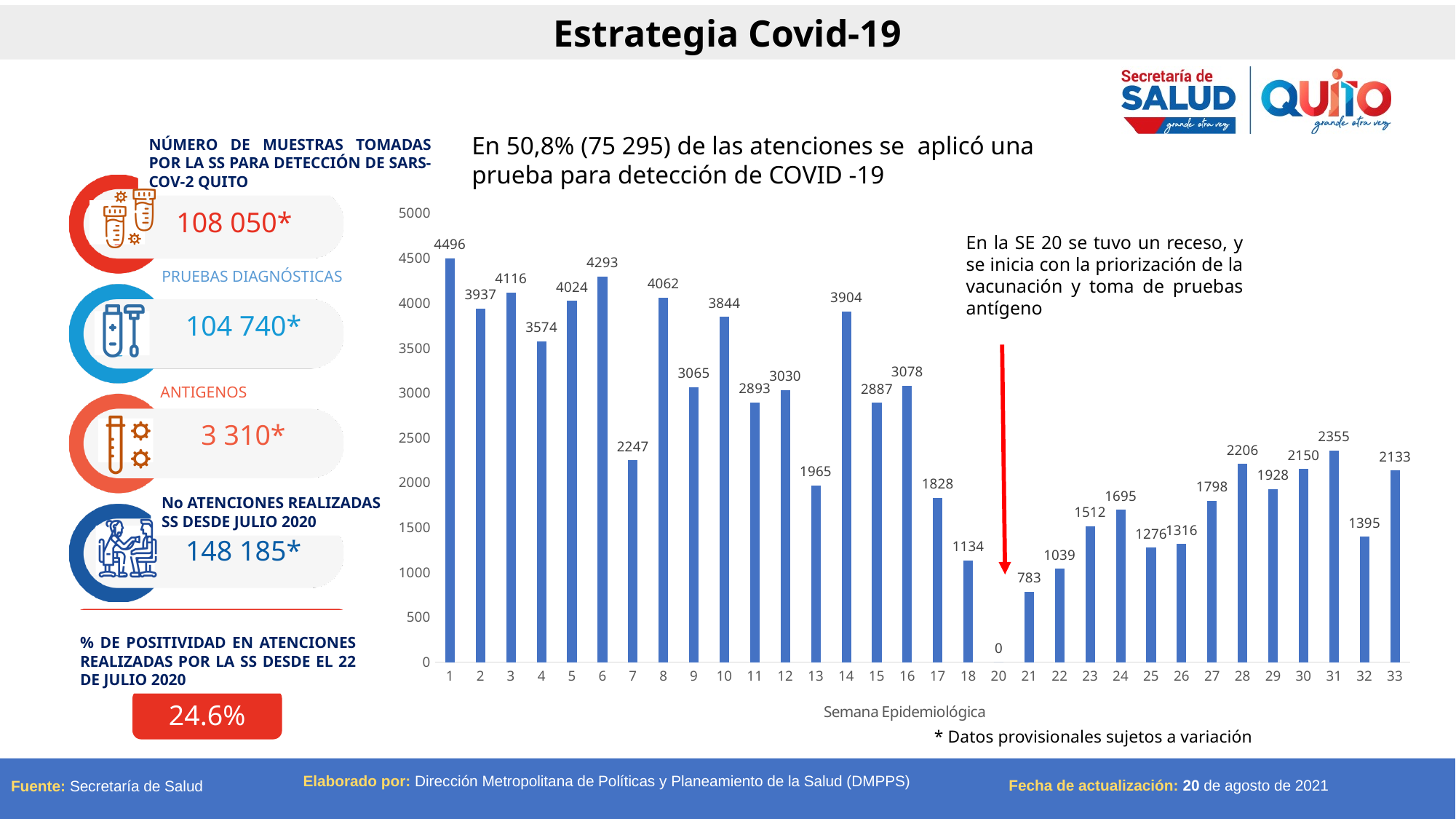
Which epidemiological week has the highest value? 1 Is the value for week 21 greater or less than 1000? less How many epidemiological weeks are shown on the x axis? 32 What is the label of the x axis of the chart? Semana Epidemiológica Do the values generally rise or fall from week 1 to week 20? fall What is the difference between the values for week 6 and week 7? 2046 What kind of chart is shown on the slide? bar chart Which epidemiological week has the lowest value? 20 Which is larger, the value for week 31 or the value for week 32? week 31 What is the value for epidemiological week 1? 4496 What is the value for epidemiological week 20? 0 What is the value for epidemiological week 33? 2133